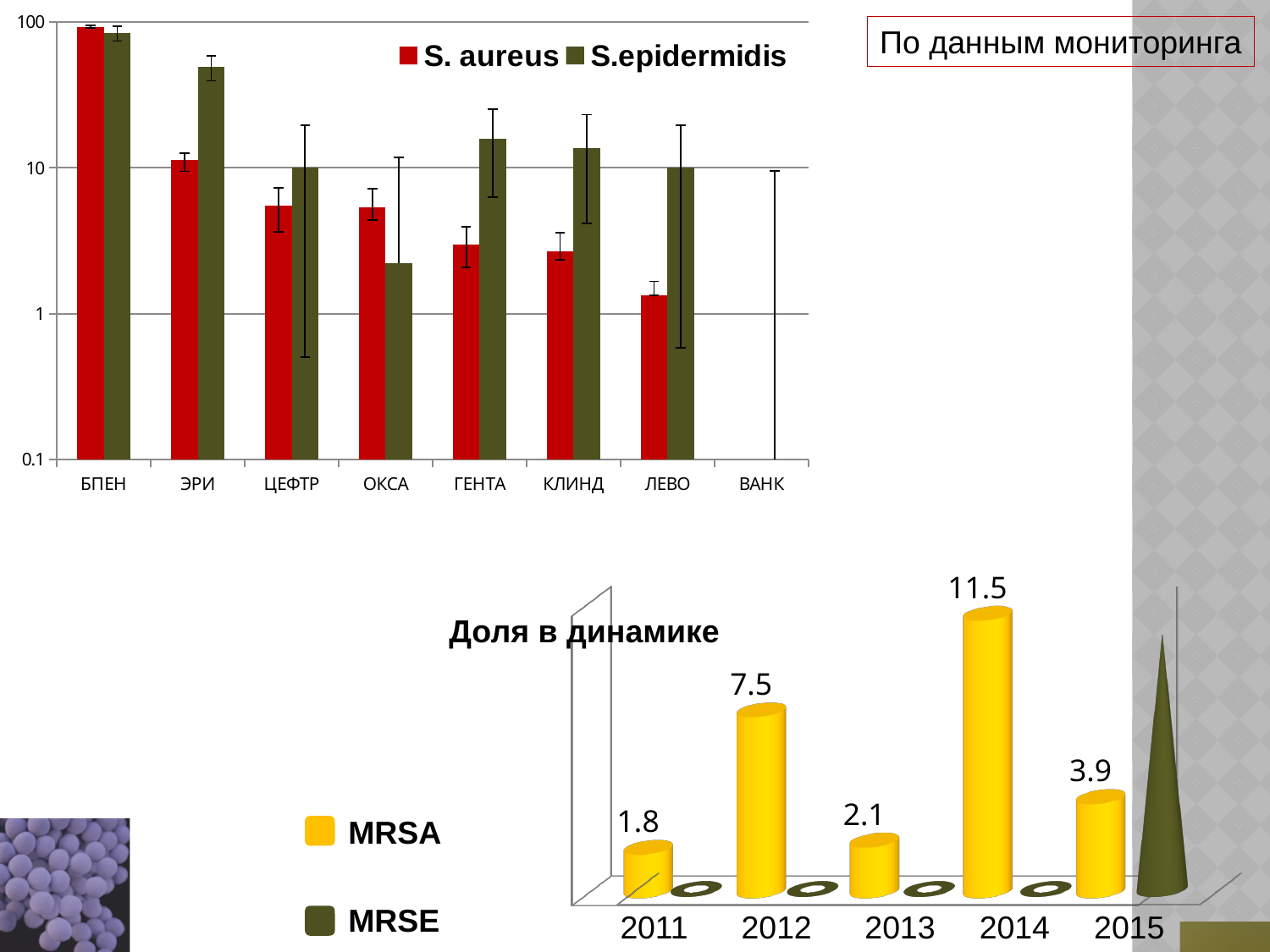
In the bottom chart 'Доля в динамике', how many years are shown on the x axis? 5 In the bottom chart 'Доля в динамике', which year has the highest MRSA value? 2014 In the bottom chart 'Доля в динамике', what is the difference between the MRSA values for 2014 and 2012? 4 In the top chart, how many antibiotic categories are shown on the x axis? 8 In the bottom chart 'Доля в динамике', what is the MRSA value for 2014? 11.5 In the bottom chart 'Доля в динамике', which year has the larger MRSA value, 2012 or 2015? 2012 What kind of chart is the top chart? bar chart In the top chart, is the S.epidermidis value for ЭРИ greater or less than 10? greater In the bottom chart 'Доля в динамике', which year has the lowest MRSA value? 2011 In the top chart, which category has the highest S. aureus value? БПЕН In the bottom chart 'Доля в динамике', what is the MRSA value for 2011? 1.8 In the bottom chart 'Доля в динамике', how many series does the legend list? 2